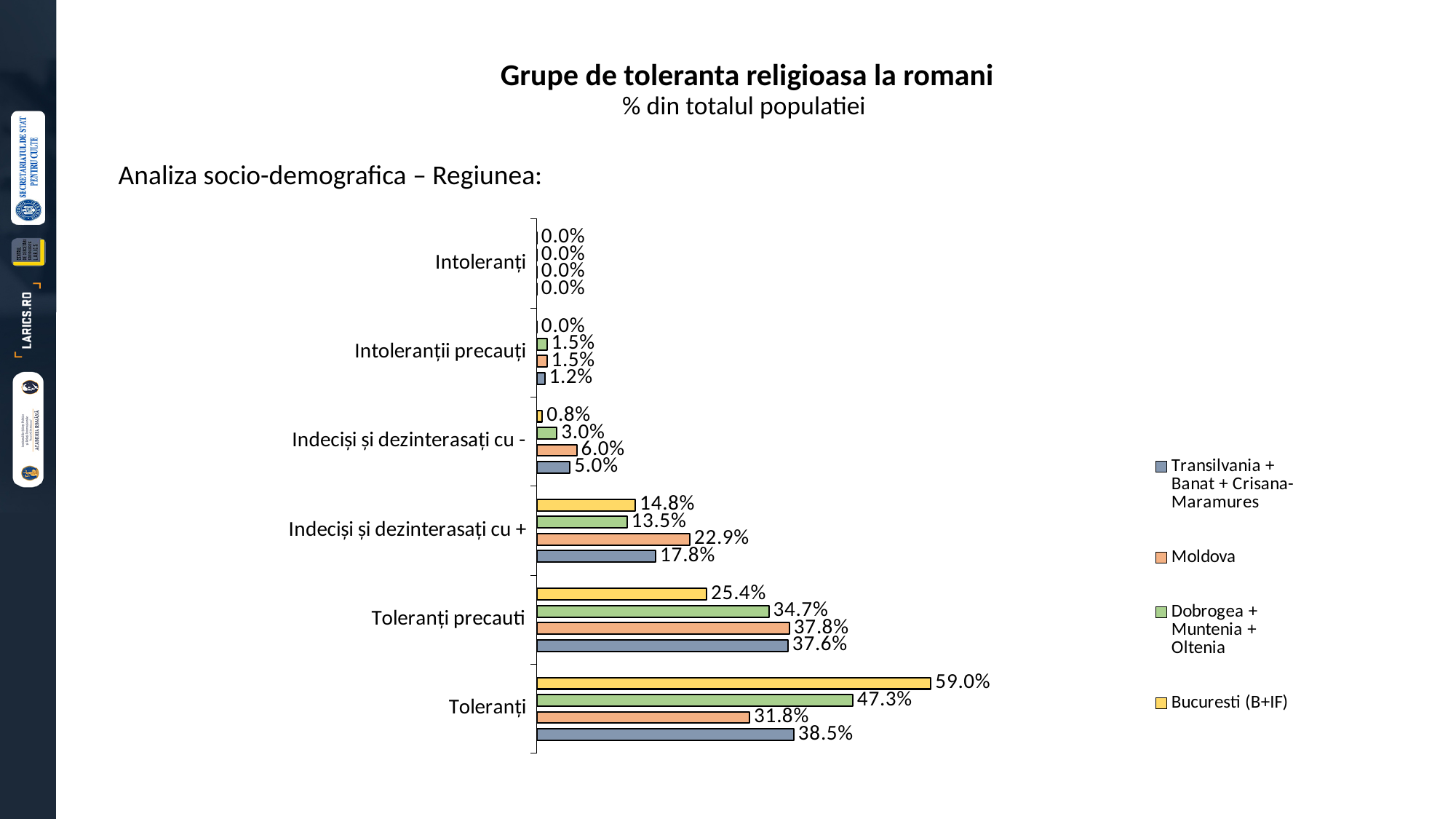
What is the value for Transilvania + Banat + Crisana-Maramures in the Toleranți precauti category? 37.6% What is the value for Moldova in the Indeciși și dezinterasați cu + category? 22.9% What kind of chart is shown on the slide? bar chart What is the subtitle shown under the chart title? % din totalul populatiei What is the value for Dobrogea + Muntenia + Oltenia in the Intoleranții precauți category? 1.5% What is the difference between the Bucuresti (B+IF) and Moldova values in the Toleranți category? 27.2% Which region has the highest value in the Toleranți category? Bucuresti (B+IF) What is the value for Bucuresti (B+IF) in the Toleranți category? 59.0% Which region has the lowest value in the Indeciși și dezinterasați cu - category? Bucuresti (B+IF) How many series does the legend list? 4 How many categories are shown on the chart? 6 In the Toleranți precauti category, which is larger: the value for Dobrogea + Muntenia + Oltenia or the value for Bucuresti (B+IF)? Dobrogea + Muntenia + Oltenia